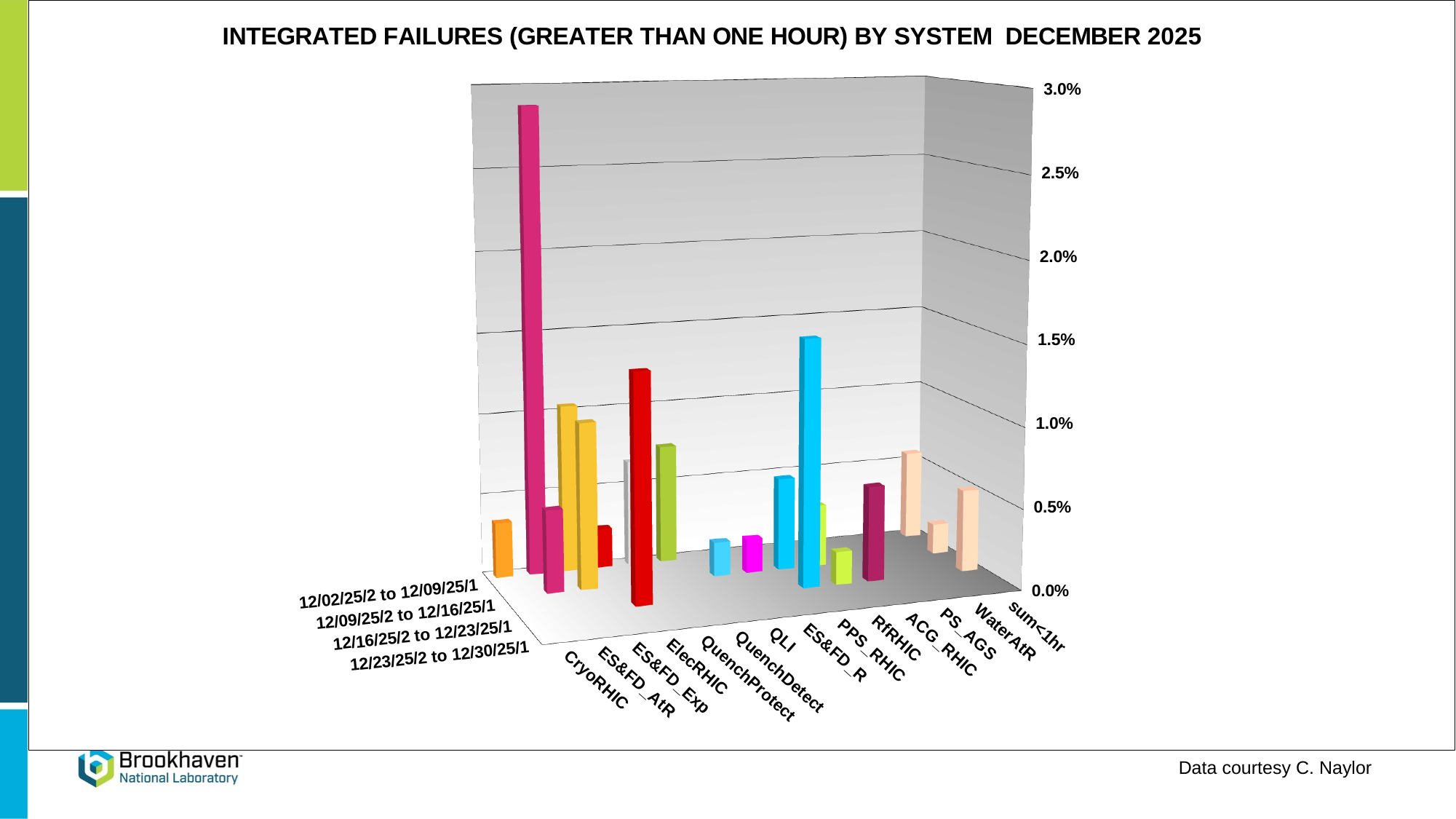
How many weekly date ranges are listed along the depth axis of the chart? 4 Is the value of the tallest bar in the chart greater or less than 2.0%? greater What kind of chart is shown on the slide? bar chart Which system category is labelled first (leftmost) on the horizontal axis? CryoRHIC How many system categories are labelled along the horizontal axis of the chart? 14 What is the title of the chart? INTEGRATED FAILURES (GREATER THAN ONE HOUR) BY SYSTEM DECEMBER 2025 Which category is labelled last (rightmost) on the horizontal axis? sum<1hr Is the value of the tallest bar in the chart greater or less than 2.5%? greater